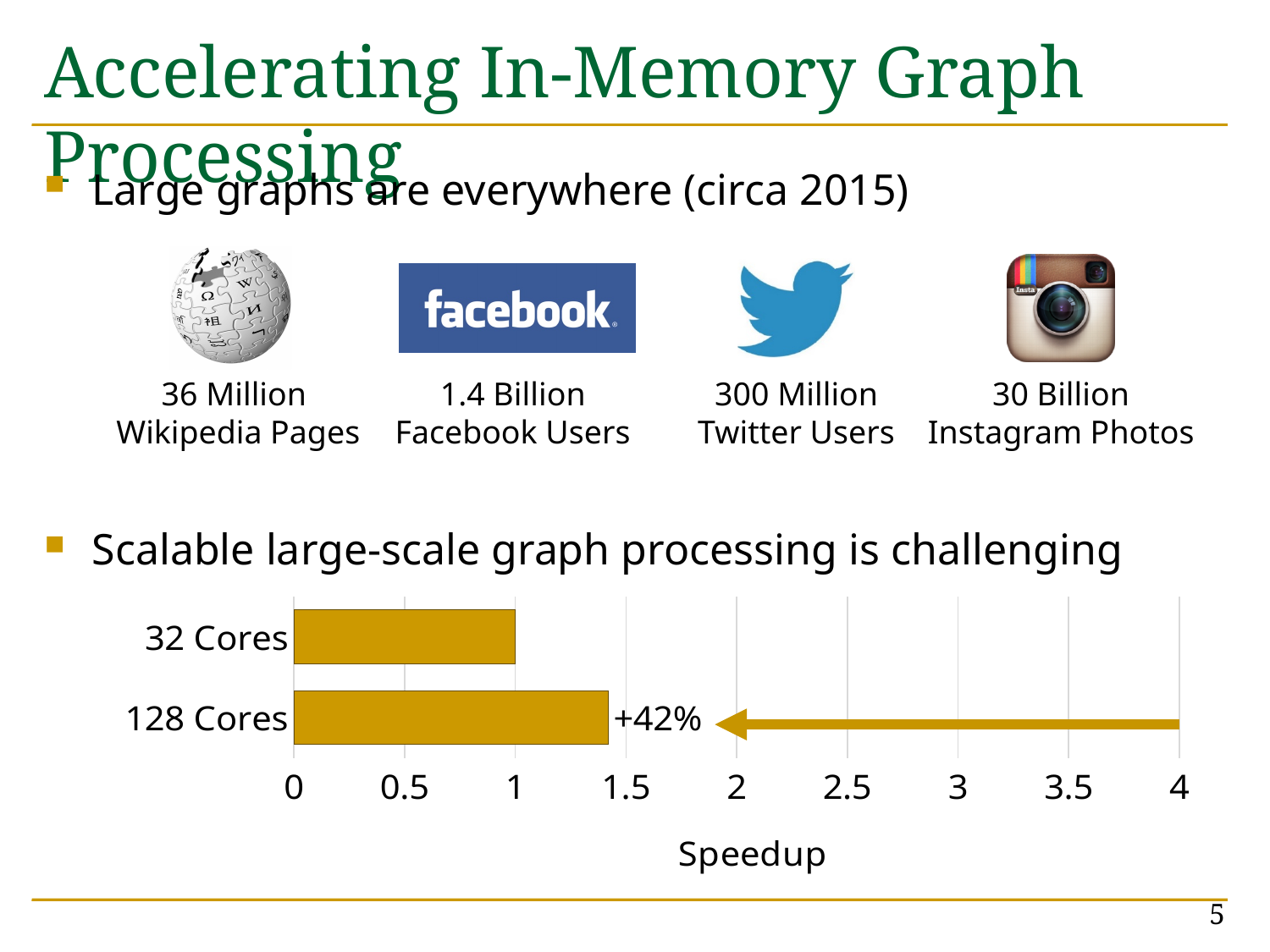
What is the title of the x axis of the chart? Speedup Which category has the higher speedup, 32 Cores or 128 Cores? 128 Cores Is the speedup for 128 Cores greater or less than 1.5? less What percentage improvement is annotated next to the 128 Cores bar? +42% What is the maximum value shown on the x axis of the chart? 4 Which category has the lowest speedup in the chart? 32 Cores Is the speedup for 128 Cores greater or less than 2? less Is the speedup for 128 Cores greater or less than 1? greater What type of chart is shown on the slide? bar chart How many categories are plotted in the chart? 2 What is the speedup value for 32 Cores? 1 Which category has the highest speedup in the chart? 128 Cores